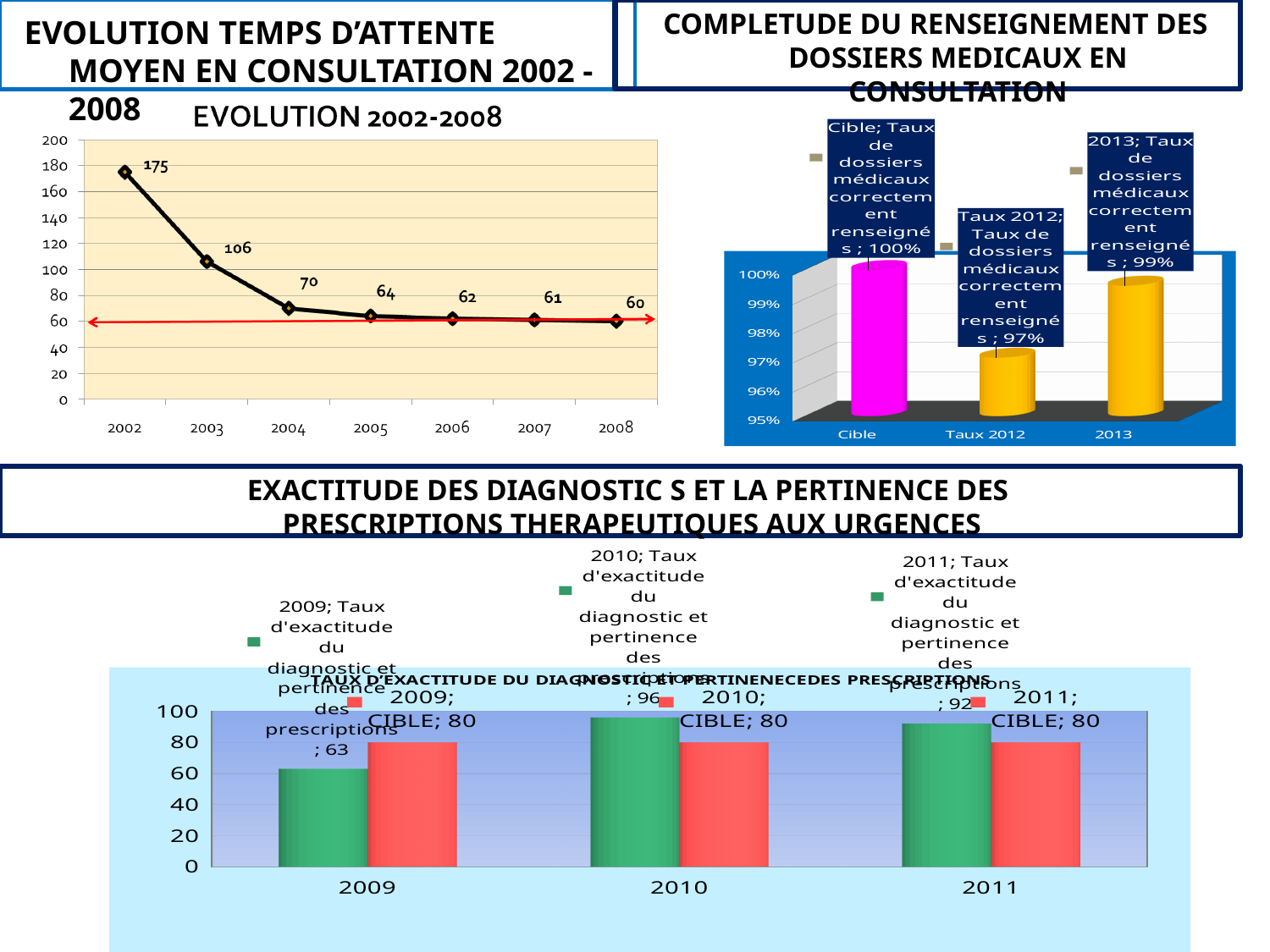
In the 'EVOLUTION 2002-2008' line chart, what is the value for 2002? 175 In the bottom chart on diagnostic accuracy, what is the 'Taux d'exactitude' value for 2009? 63 How many years are plotted in the 'EVOLUTION 2002-2008' line chart? 7 In the 'EVOLUTION 2002-2008' line chart, which year has the highest value? 2002 In the 'EVOLUTION 2002-2008' line chart, do the values rise or fall from 2002 to 2008? fall In the 'EVOLUTION 2002-2008' line chart, what is the difference between the values for 2002 and 2003? 69 In the top-right chart on completeness of medical records, what is the value for 2013? 99% In the bottom chart on diagnostic accuracy, which is larger for 2010: the 'Taux d'exactitude' value or the CIBLE value? Taux d'exactitude (96) In the bottom chart on diagnostic accuracy, what is the difference between the 2011 'Taux d'exactitude' value and the CIBLE value? 12 In the top-right chart on completeness of medical records, what is the value for 'Taux 2012'? 97% In the top-right chart on completeness of medical records, which category has the lowest value? Taux 2012 In the 'EVOLUTION 2002-2008' line chart, what is the value for 2008? 60